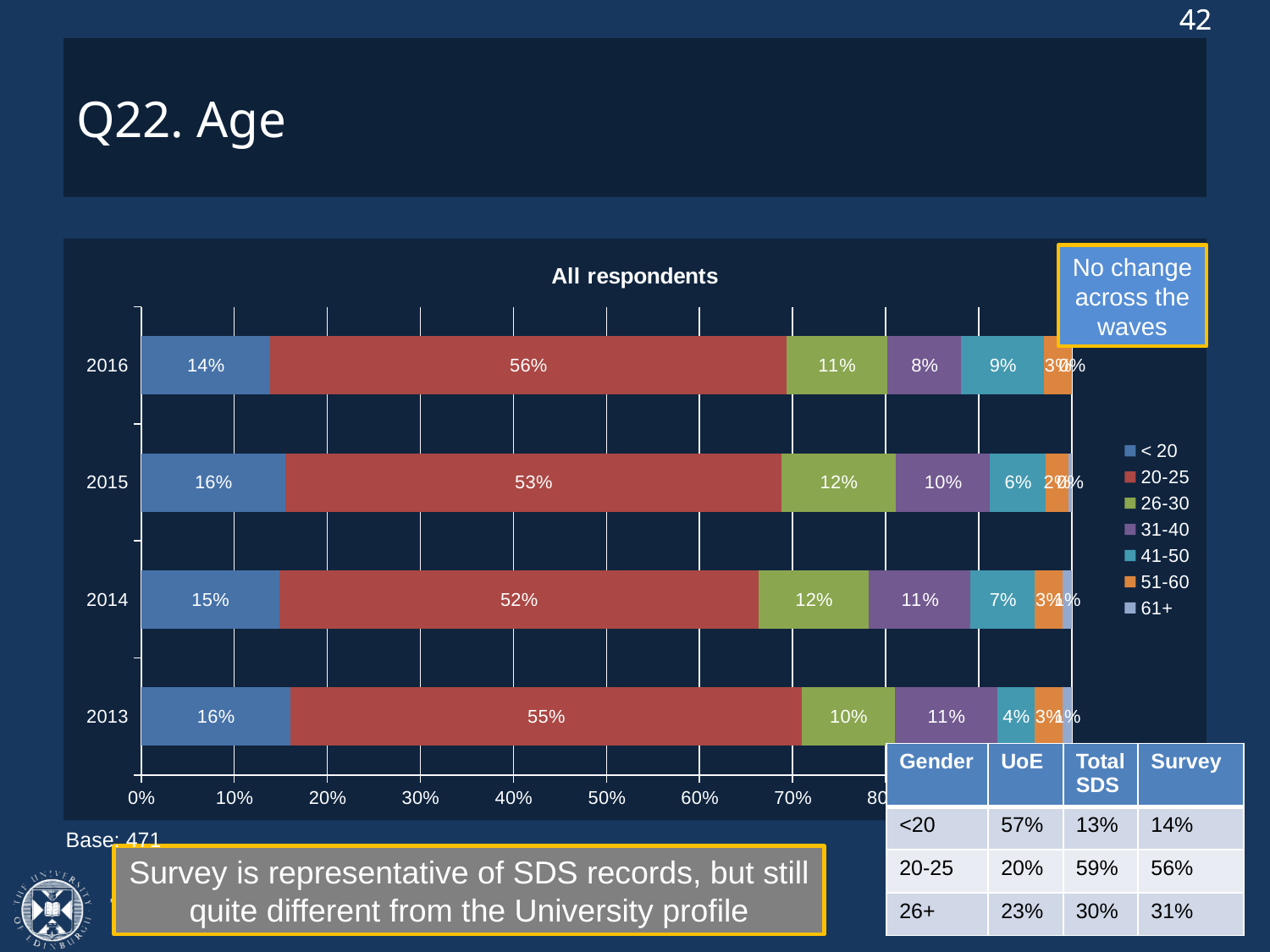
What percentage of respondents were aged 41-50 in 2016? 9% How many age groups does the legend list? 7 In which year was the share of respondents aged 20-25 the highest? 2016 What percentage of respondents were aged under 20 in 2015? 16% Which year had a larger share of respondents aged 41-50, 2015 or 2016? 2016 What percentage of respondents were aged 26-30 in 2014? 12% In which year was the share of respondents aged 41-50 the lowest? 2013 How many years are shown on the chart? 4 What percentage of respondents were aged 31-40 in 2013? 11% By how many percentage points did the 20-25 share in 2016 exceed the 20-25 share in 2014? 4 percentage points What type of chart is shown on the slide? Stacked bar chart What percentage of respondents were aged 20-25 in 2016? 56%